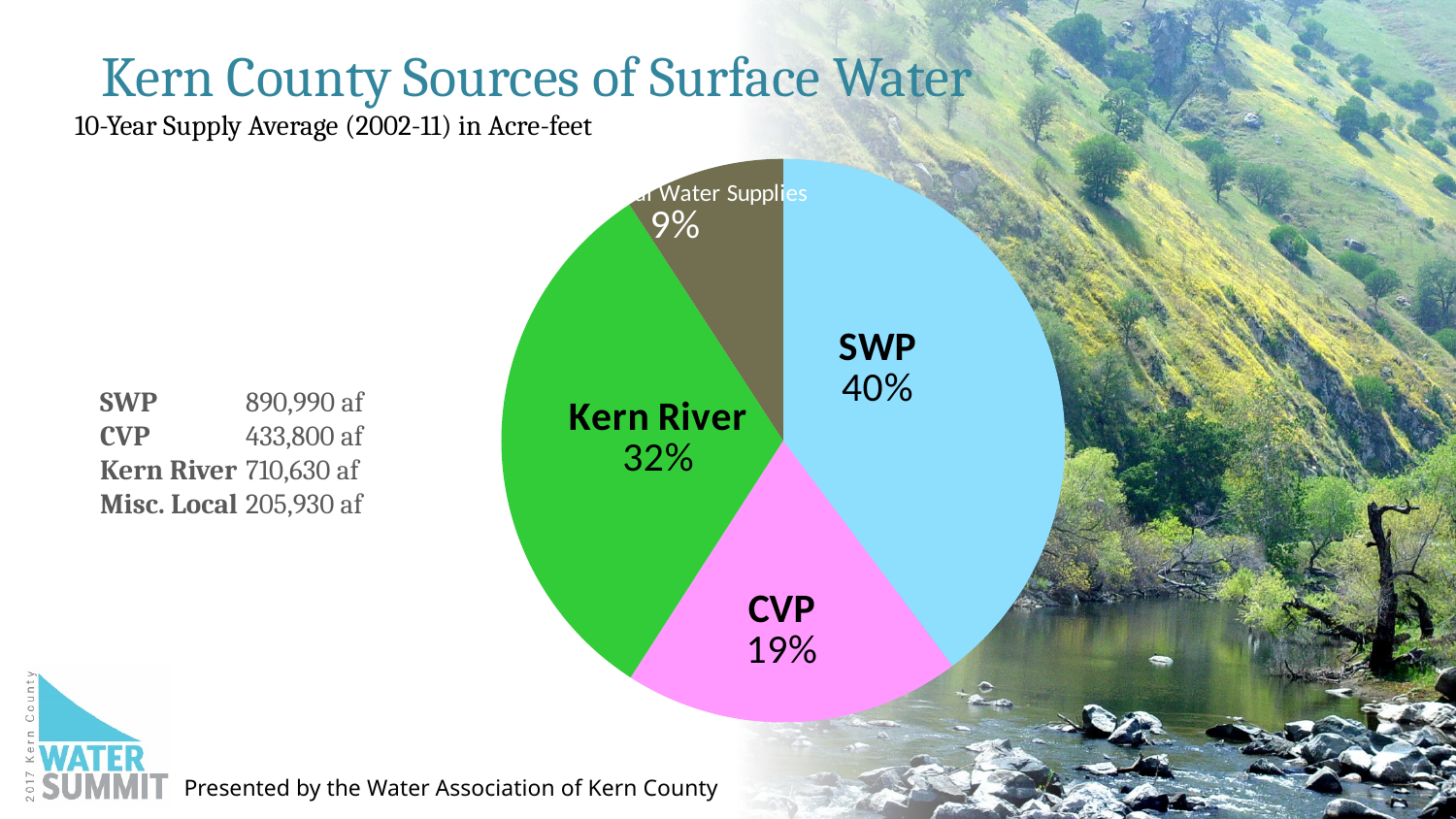
What is the percentage shown on the smallest slice of the pie chart? 9% Which slice is larger, Kern River or CVP? Kern River By how many percentage points does the SWP share exceed the CVP share? 21 percentage points What is the title of the slide containing the pie chart? Kern County Sources of Surface Water What share of the pie is labelled Kern River? 32% What share of the pie does SWP account for? 40% By how many percentage points is the Kern River share larger than the 9% slice? 23 percentage points Which slice of the pie chart is the largest? SWP How many slices does the pie chart have? 4 What colour is the SWP slice of the pie chart? Light blue What percentage is shown for CVP in the pie chart? 19% What kind of chart is shown on the slide? Pie chart